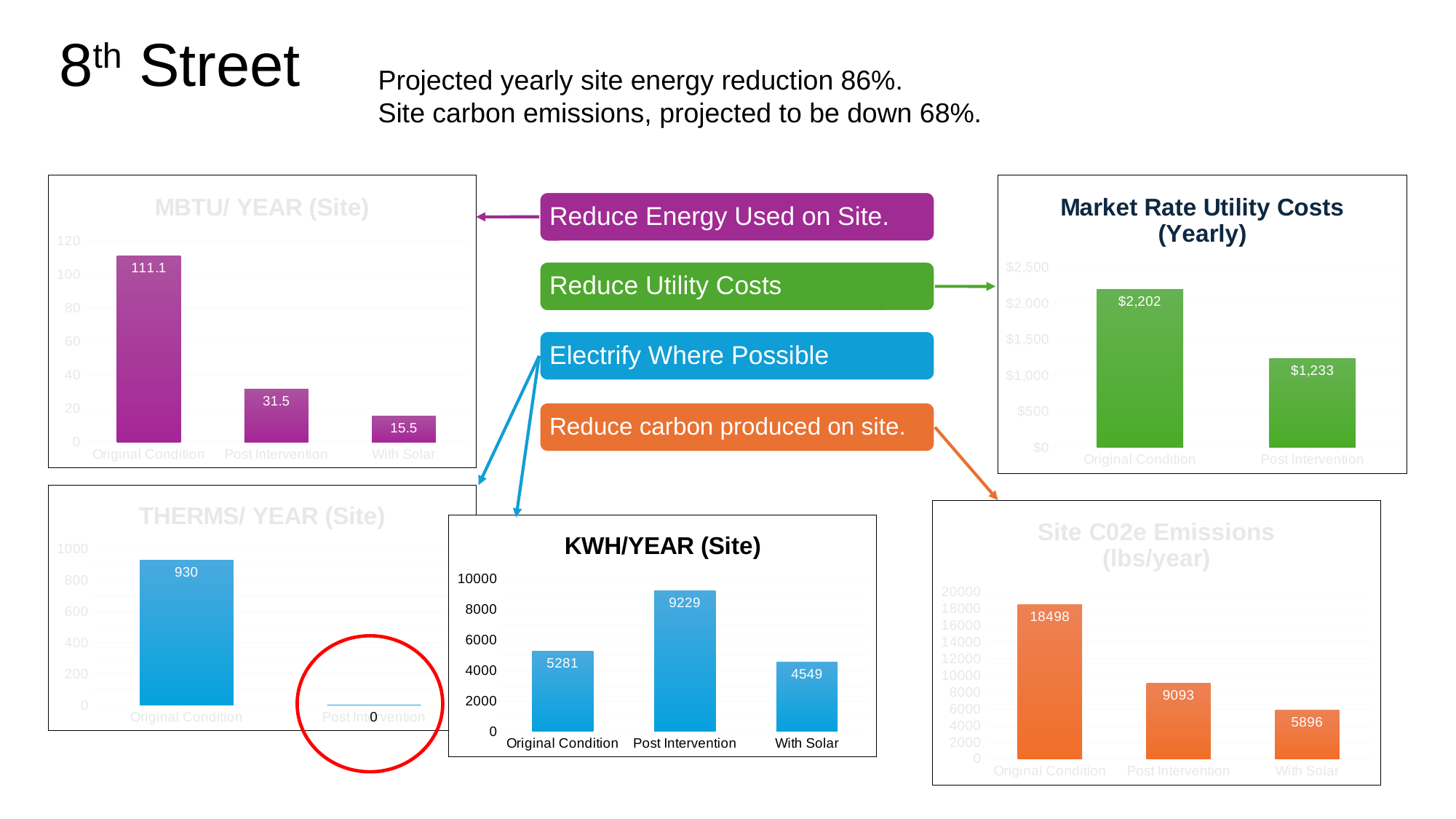
In the KWH/YEAR (Site) chart, which is larger, Original Condition or With Solar? Original Condition In the Site C02e Emissions (lbs/year) chart, what is the value for Post Intervention? 9093 What kind of chart is the Site C02e Emissions (lbs/year) chart? Bar chart In the MBTU/ YEAR (Site) chart, what is the difference between Post Intervention and With Solar? 16 In the Market Rate Utility Costs (Yearly) chart, what is the value for Post Intervention? $1,233 In the Site C02e Emissions (lbs/year) chart, which category has the lowest value? With Solar In the Market Rate Utility Costs (Yearly) chart, how many categories are shown? 2 In the THERMS/ YEAR (Site) chart, what is the value for Original Condition? 930 In the KWH/YEAR (Site) chart, which category has the highest value? Post Intervention In the MBTU/ YEAR (Site) chart, what is the value for Original Condition? 111.1 In the THERMS/ YEAR (Site) chart, what is the value for Post Intervention? 0 In the KWH/YEAR (Site) chart, what is the difference between Post Intervention and Original Condition? 3948